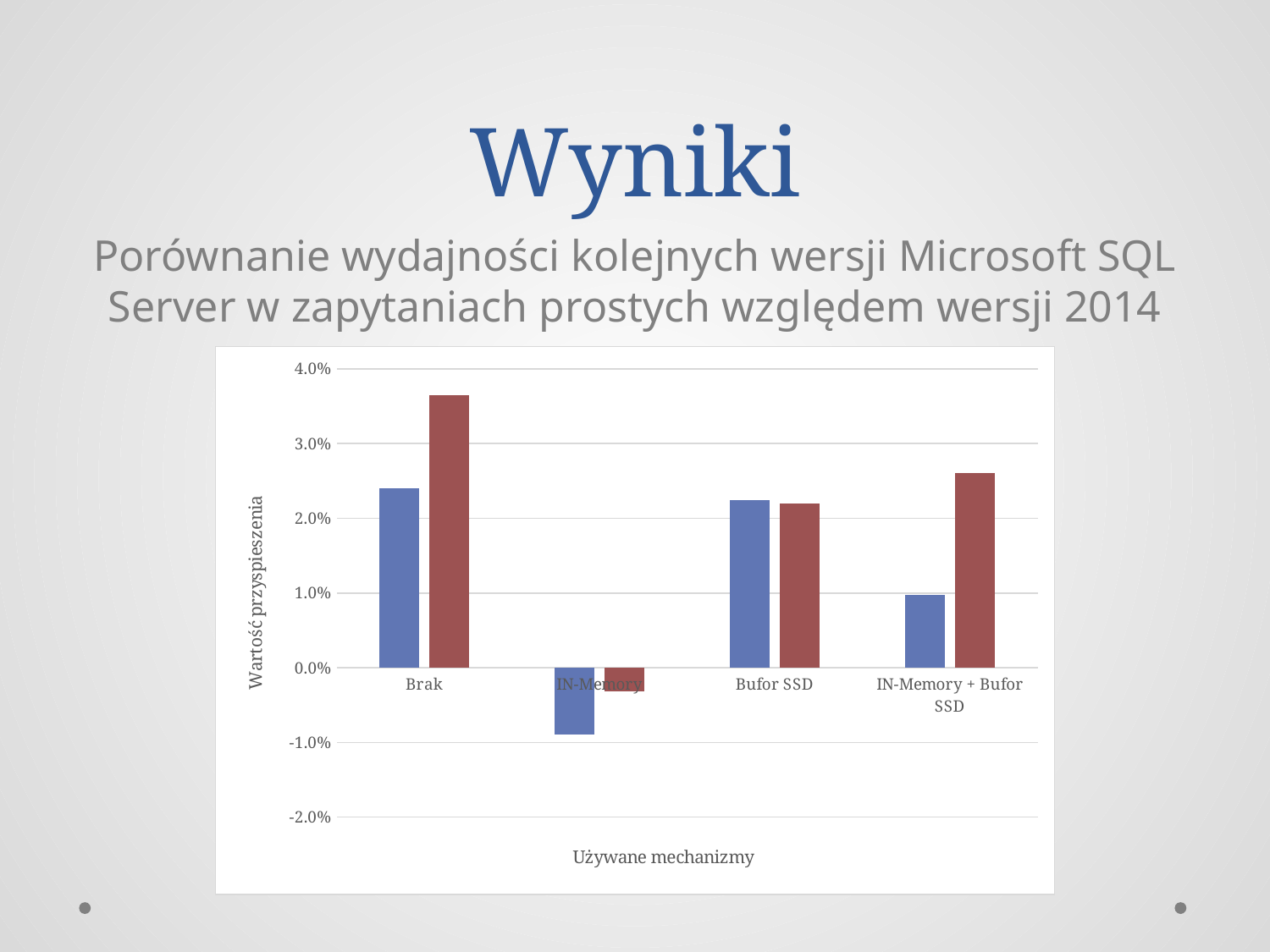
Which is larger: the red bar for Brak or the red bar for Bufor SSD? Brak Is the value of the blue bar for IN-Memory greater or less than 0.0%? less What is the title of the vertical axis of the chart? Wartość przyspieszenia How many categories are shown on the x axis of the chart? 4 Is the value of the blue bar for Brak greater or less than 2.0%? greater What kind of chart is shown on the slide? bar chart Is the value of the red bar for IN-Memory + Bufor SSD greater or less than 2.0%? greater Which category has the highest bar in the chart? Brak Which category has the lowest bar in the chart? IN-Memory What is the title of the horizontal axis of the chart? Używane mechanizmy